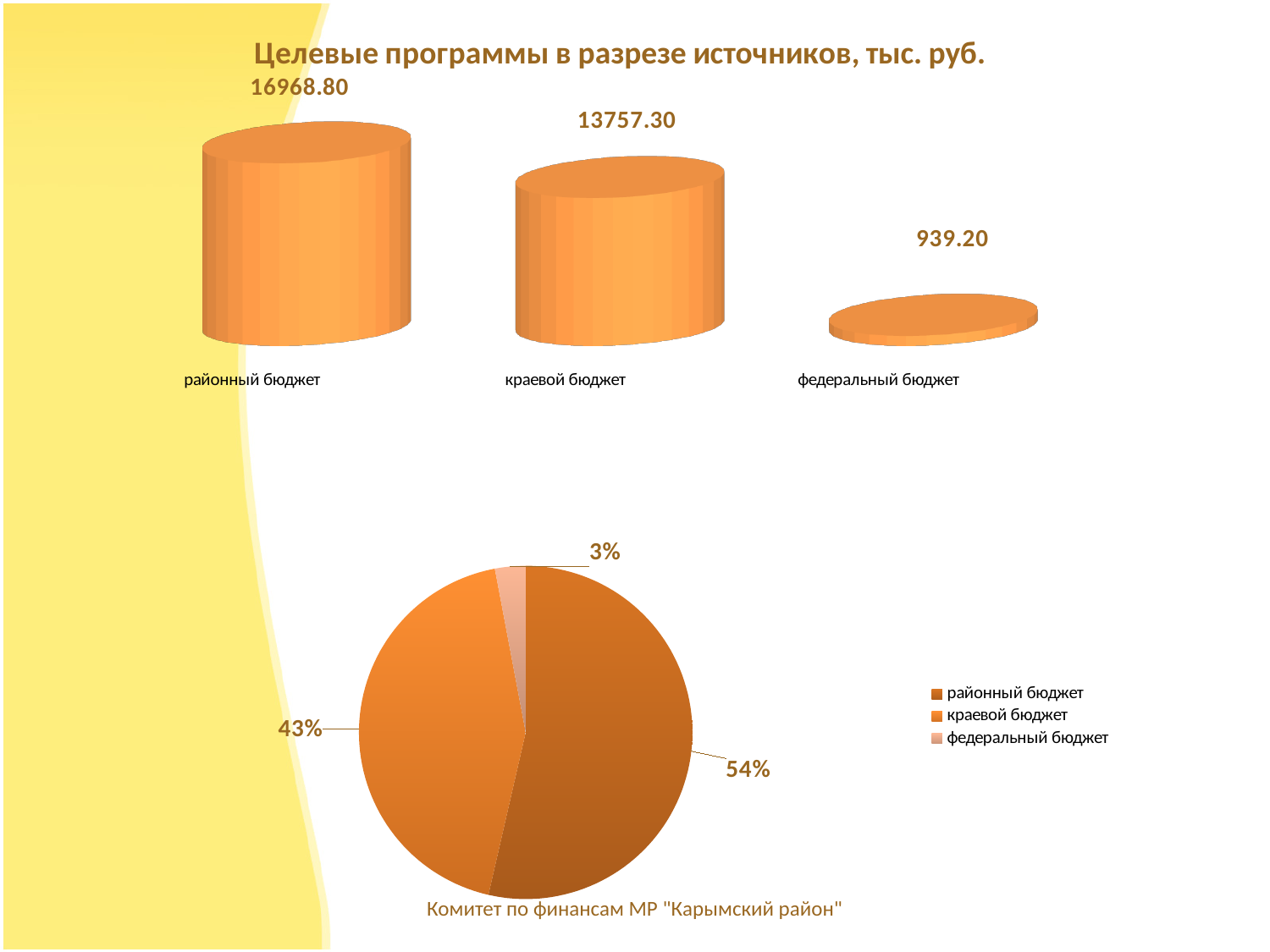
How many entries does the legend of the pie chart at the bottom of the slide list? 3 In the bar chart at the top of the slide, how many categories are shown? 3 In the pie chart at the bottom of the slide, what share does федеральный бюджет have? 3% In the bar chart at the top of the slide, which category has the lowest value? федеральный бюджет In the bar chart titled "Целевые программы в разрезе источников, тыс. руб.", what is the value for краевой бюджет? 13757.30 In the bar chart titled "Целевые программы в разрезе источников, тыс. руб.", what is the value for федеральный бюджет? 939.20 In the bar chart at the top of the slide, what is the difference between the values for районный бюджет and краевой бюджет? 3211.50 What kind of chart is the chart at the top of the slide? bar chart In the pie chart at the bottom of the slide, which is larger: the slice for краевой бюджет or the slice for районный бюджет? районный бюджет In the bar chart at the top of the slide, which category has the highest value? районный бюджет In the bar chart titled "Целевые программы в разрезе источников, тыс. руб.", what is the value for районный бюджет? 16968.80 In the pie chart at the bottom of the slide, what share does районный бюджет have? 54%